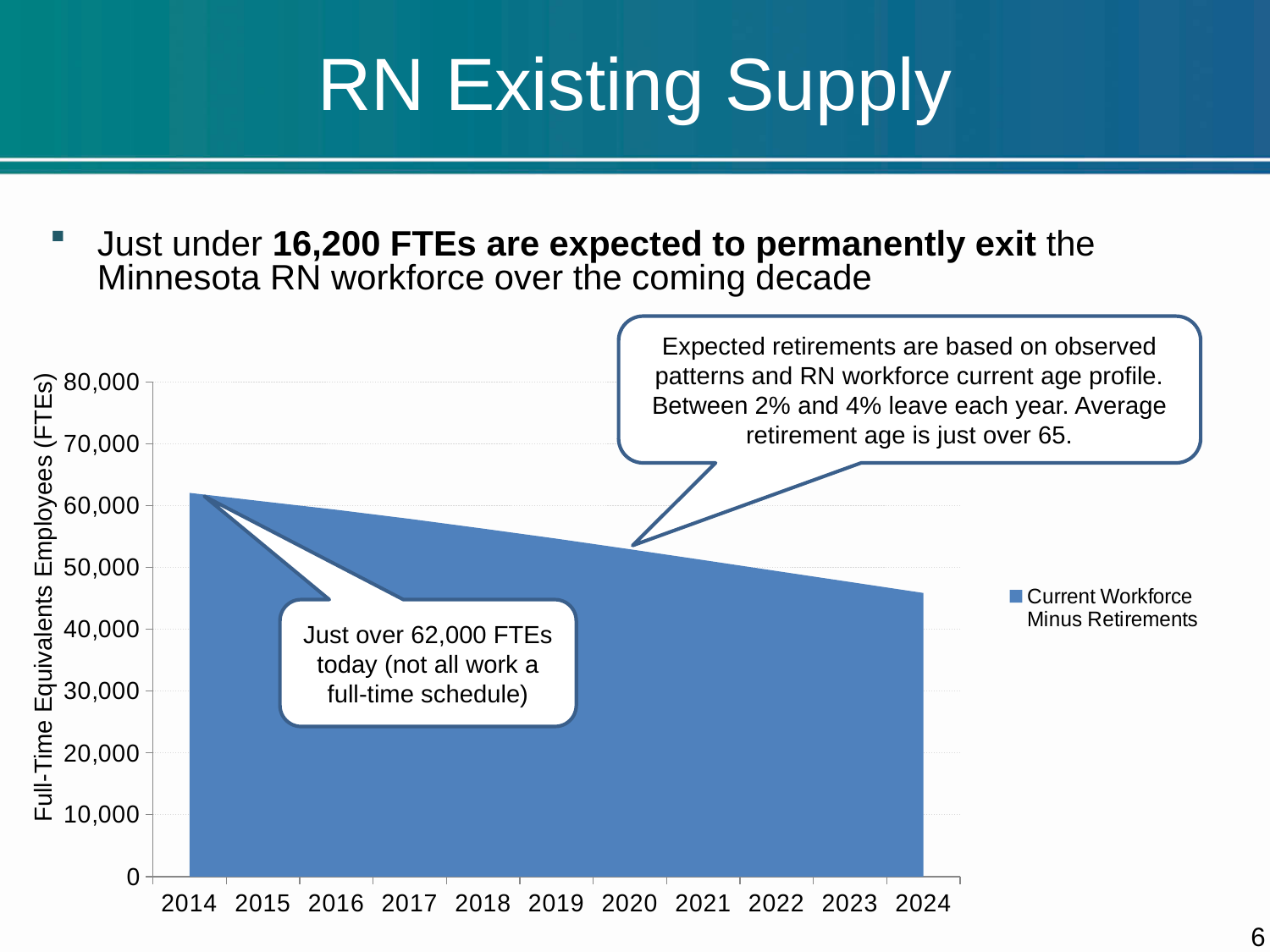
Is the value for 2024 greater or less than 50,000? less Is the value for 2019 greater or less than 50,000? greater Which year has the larger value, 2016 or 2022? 2016 Is the value for 2014 greater or less than 60,000? greater Which year has the lowest value in the chart? 2024 What is the label on the chart's vertical axis? Full-Time Equivalents Employees (FTEs) What is the name of the series shown in the chart's legend? Current Workforce Minus Retirements What kind of chart is shown on the slide? Area chart Do the values in the chart rise or fall from 2014 to 2024? Fall How many years are shown along the x axis of the chart? 11 Which year has the highest value in the chart? 2014 How many series does the chart's legend list? 1